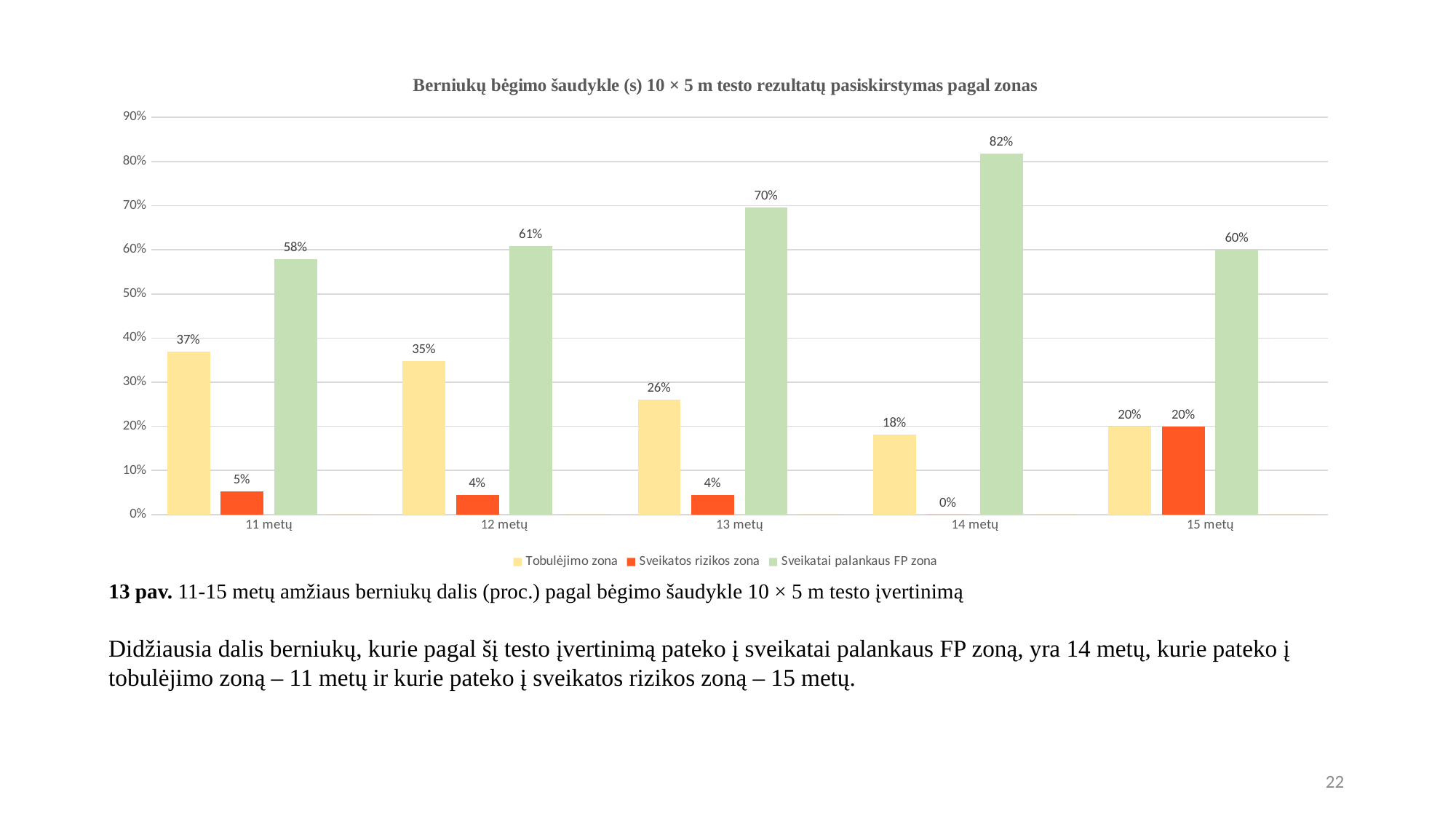
Is the value for Sveikatai palankaus FP zona at 13 metų greater or less than 60%? greater What is the value for Sveikatos rizikos zona at 15 metų? 20% What is the difference between the Sveikatai palankaus FP zona values at 14 metų and 11 metų? 24% Which age group has the highest value for Sveikatai palankaus FP zona? 14 metų What is the value for Tobulėjimo zona at 11 metų? 37% Do the Tobulėjimo zona values rise or fall from 11 metų to 14 metų? fall Which is larger: Tobulėjimo zona at 12 metų or Tobulėjimo zona at 13 metų? Tobulėjimo zona at 12 metų What kind of chart is shown on the slide? bar chart How many age groups are shown on the x axis? 5 How many series does the legend list? 3 What is the value for Sveikatai palankaus FP zona at 14 metų? 82% Which age group has the lowest value for Sveikatos rizikos zona? 14 metų